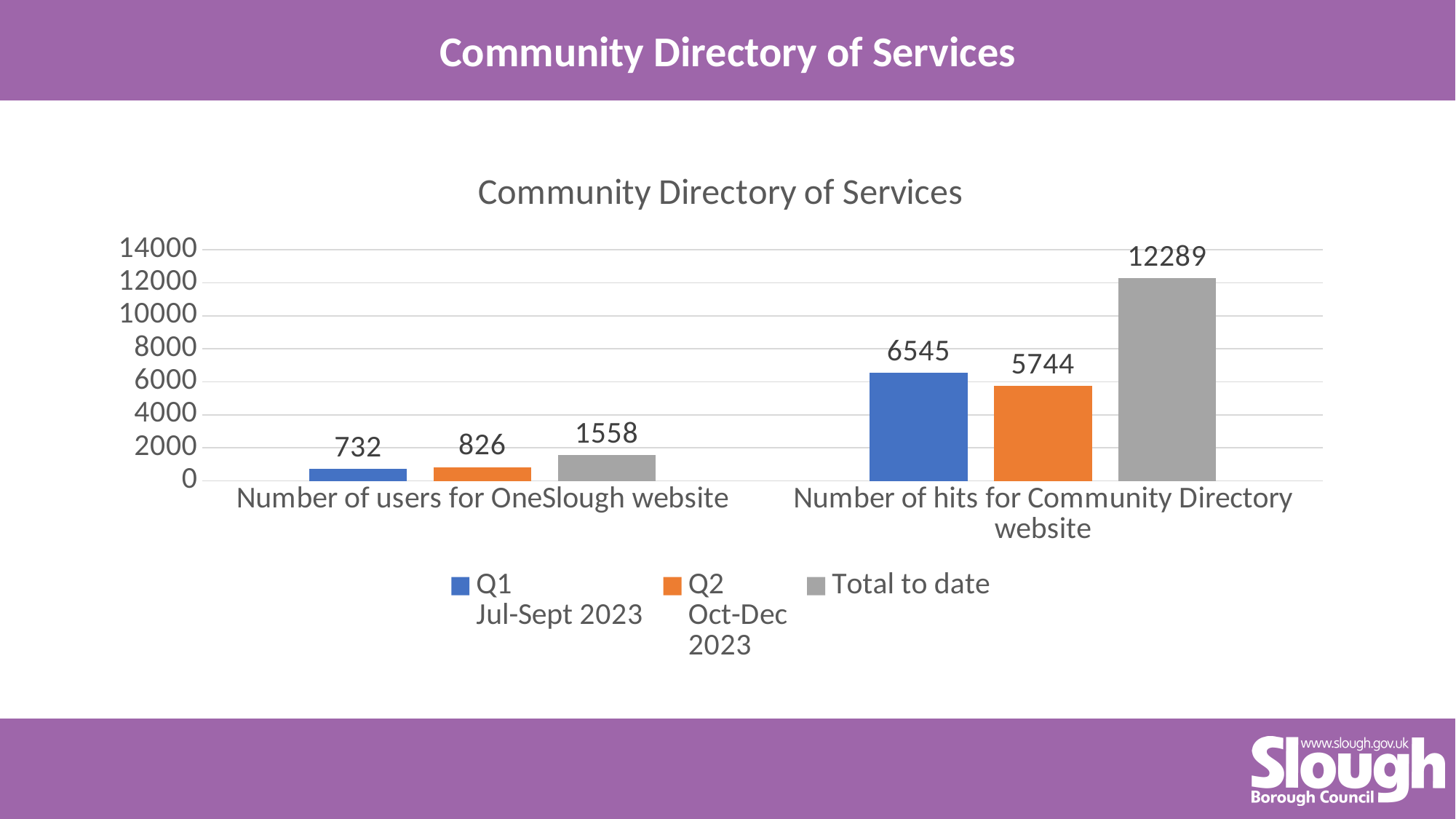
What is the Total to date value for Number of hits for Community Directory website? 12289 Which series has the lowest value for Number of users for OneSlough website? Q1 Jul-Sept 2023 What is the Q1 Jul-Sept 2023 value for Number of users for OneSlough website? 732 How many categories are shown on the x axis? 2 Which series has the highest value for Number of hits for Community Directory website? Total to date What is the Total to date value for Number of users for OneSlough website? 1558 What kind of chart is shown on the slide? Bar chart What is the Q2 Oct-Dec 2023 value for Number of hits for Community Directory website? 5744 Which is larger for Number of users for OneSlough website: Q1 Jul-Sept 2023 or Q2 Oct-Dec 2023? Q2 Oct-Dec 2023 What is the difference between the Q1 Jul-Sept 2023 and Q2 Oct-Dec 2023 values for Number of hits for Community Directory website? 801 Is the Total to date value for Number of hits for Community Directory website greater or less than 12000? greater How many series does the legend list? 3